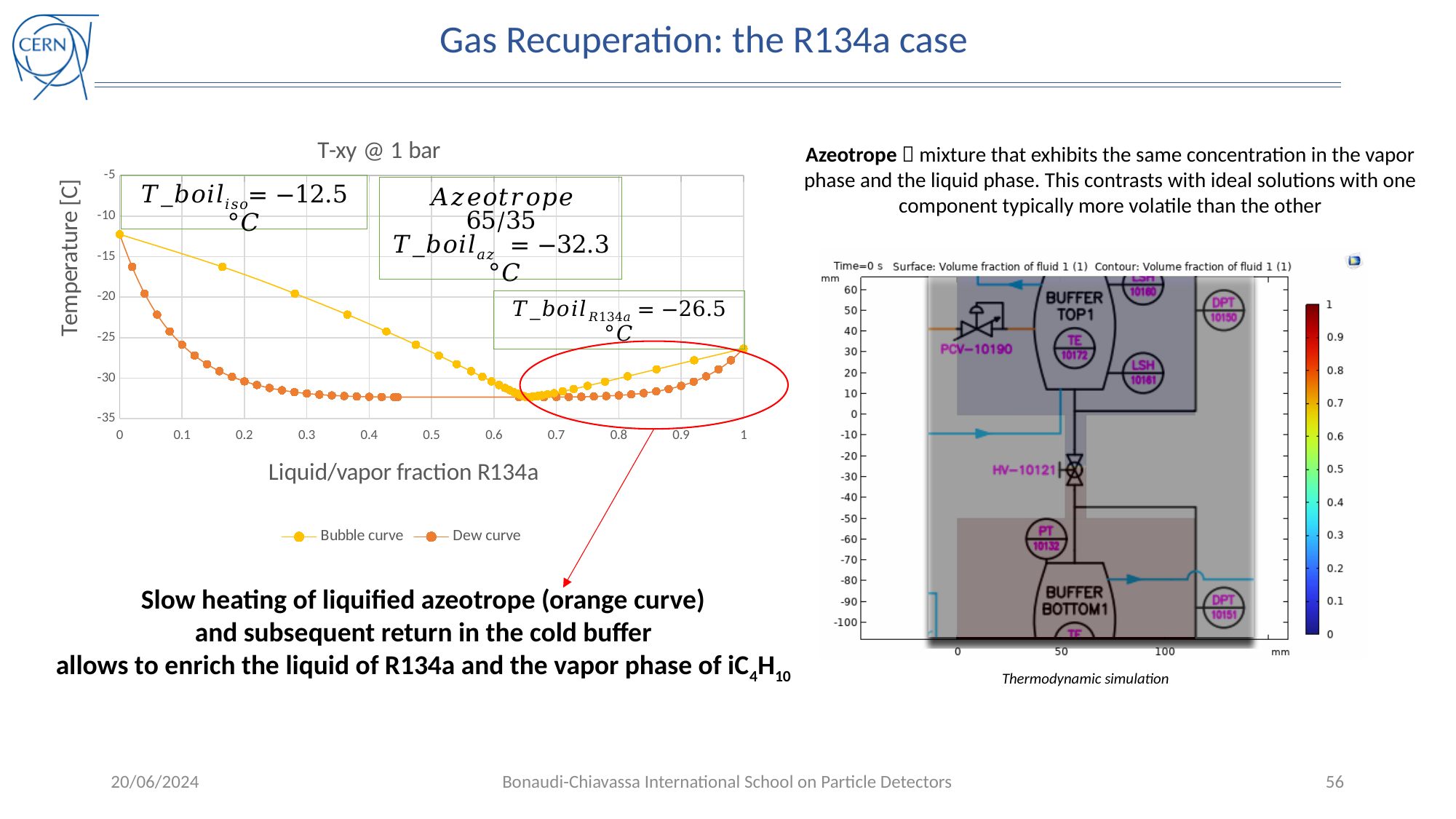
In the T-xy @ 1 bar chart, does the Dew curve rise or fall as the fraction increases from 0.8 to 1? rise In the T-xy @ 1 bar chart, which series has the higher temperature at a fraction of 0.3, the Bubble curve or the Dew curve? Bubble curve In the T-xy @ 1 bar chart, is the Bubble curve value at a fraction of 0.3 greater or less than -25? greater What is the title of the chart on the left of the slide? T-xy @ 1 bar In the T-xy @ 1 bar chart, does the Bubble curve rise or fall as the fraction increases from 0 to 0.5? fall How many series does the legend of the T-xy @ 1 bar chart list? 2 In the T-xy @ 1 bar chart, is the Bubble curve value at a fraction of 0.5 greater or less than -25? less In the T-xy @ 1 bar chart, is the Bubble curve value at a fraction of 0.1 greater or less than -20? greater What is the label of the x axis of the T-xy @ 1 bar chart? Liquid/vapor fraction R134a In the T-xy @ 1 bar chart, which series has the higher temperature at a fraction of 0.9, the Bubble curve or the Dew curve? Bubble curve What kind of chart is the T-xy @ 1 bar chart? line chart